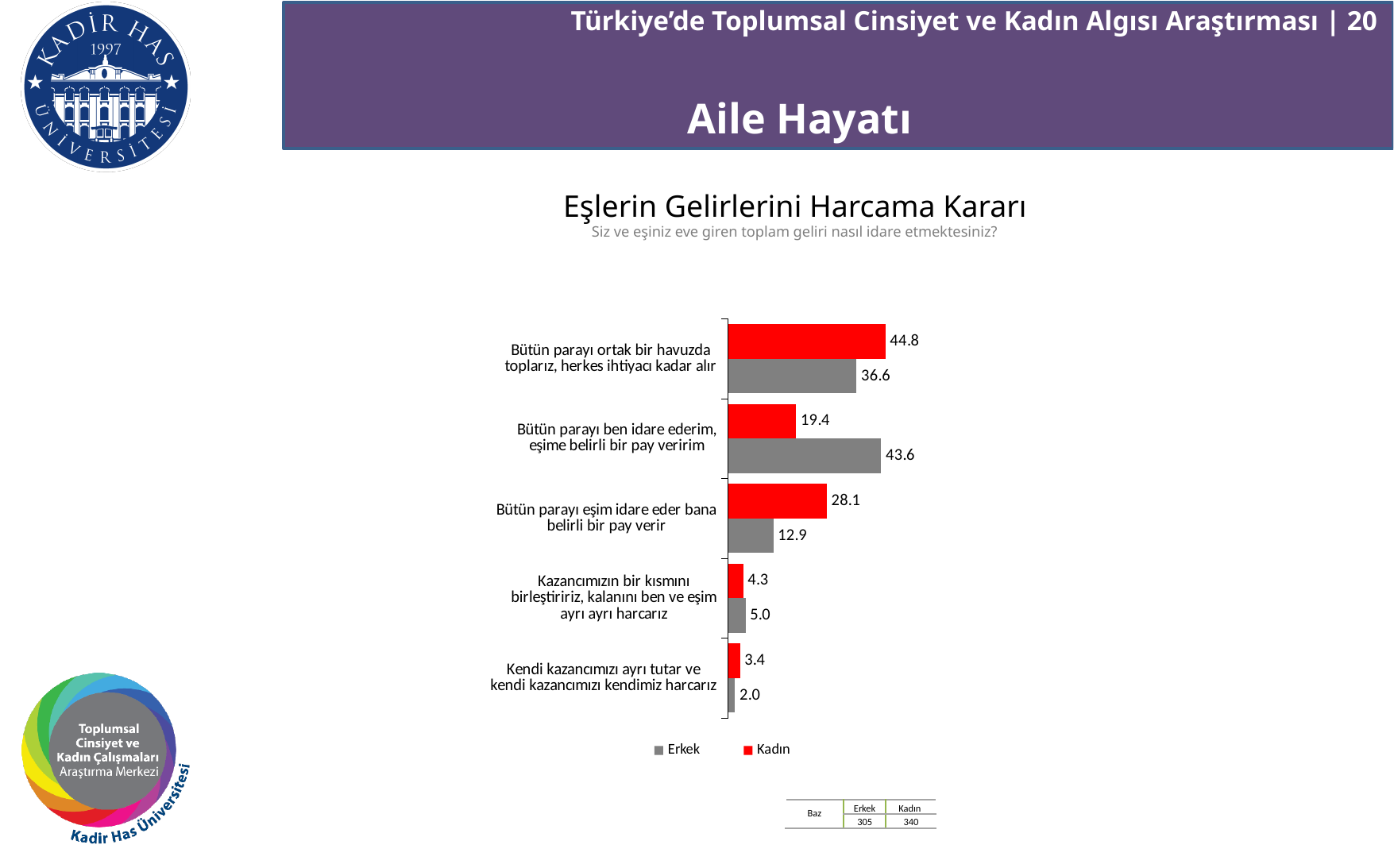
How many series does the legend list? 2 What is the Kadın value for "Bütün parayı ortak bir havuzda toplarız, herkes ihtiyacı kadar alır"? 44.8 What is the difference between the Erkek and Kadın values for "Bütün parayı ben idare ederim, eşime belirli bir pay veririm"? 24.2 What is the Erkek value for "Bütün parayı ben idare ederim, eşime belirli bir pay veririm"? 43.6 For "Bütün parayı eşim idare eder bana belirli bir pay verir", which is larger, the Erkek or the Kadın value? Kadın Which colour represents the Kadın series in the chart? Red Which category has the highest Erkek value? Bütün parayı ben idare ederim, eşime belirli bir pay veririm What kind of chart is shown on the slide? Bar chart Which category has the lowest Kadın value? Kendi kazancımızı ayrı tutar ve kendi kazancımızı kendimiz harcarız How many categories are shown in the chart? 5 What is the Erkek value for "Bütün parayı eşim idare eder bana belirli bir pay verir"? 12.9 What is the difference between the Kadın and Erkek values for "Bütün parayı ortak bir havuzda toplarız, herkes ihtiyacı kadar alır"? 8.2